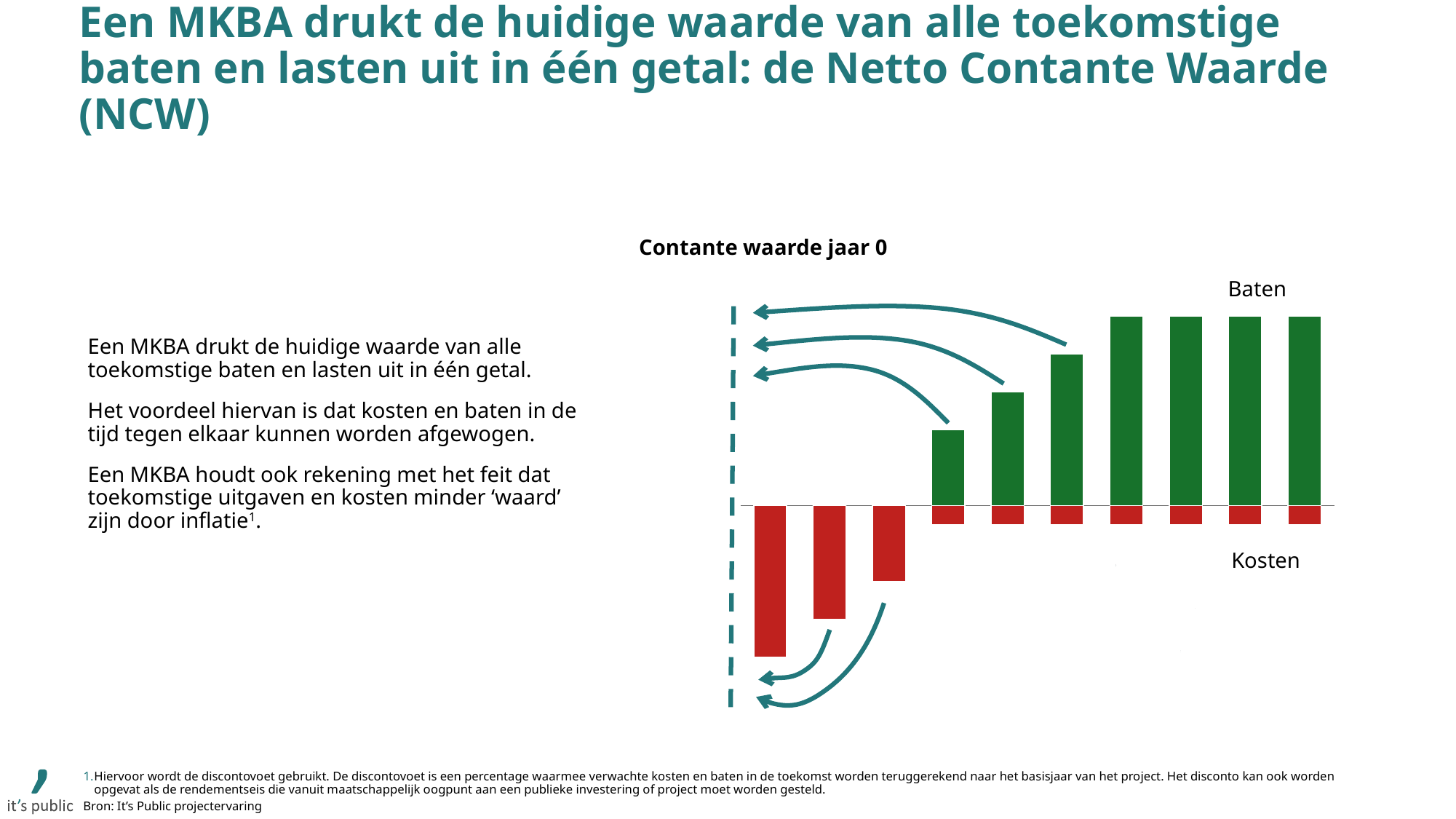
Which two series are labelled on the chart? Baten and Kosten Which bar has the largest Kosten (red) value: the first bar or the third bar? The first bar What is the title of the chart? Contante waarde jaar 0 What kind of chart is shown on the slide? Bar chart How many bars in the chart show only Kosten (red) and no Baten (green)? 3 Which of the green Baten bars is the smallest? The first green bar (fourth bar from the left) How many bars (periods) are plotted along the x axis of the chart? 10 How many bars in the chart include a green Baten portion? 7 Which bar shows the largest Kosten (red) value in the chart? The first bar on the left How many series are labelled on the chart? 2 Do the green Baten bars rise or fall from left to right across the chart? Rise Among the first three red Kosten bars, do they get larger or smaller from left to right? Smaller